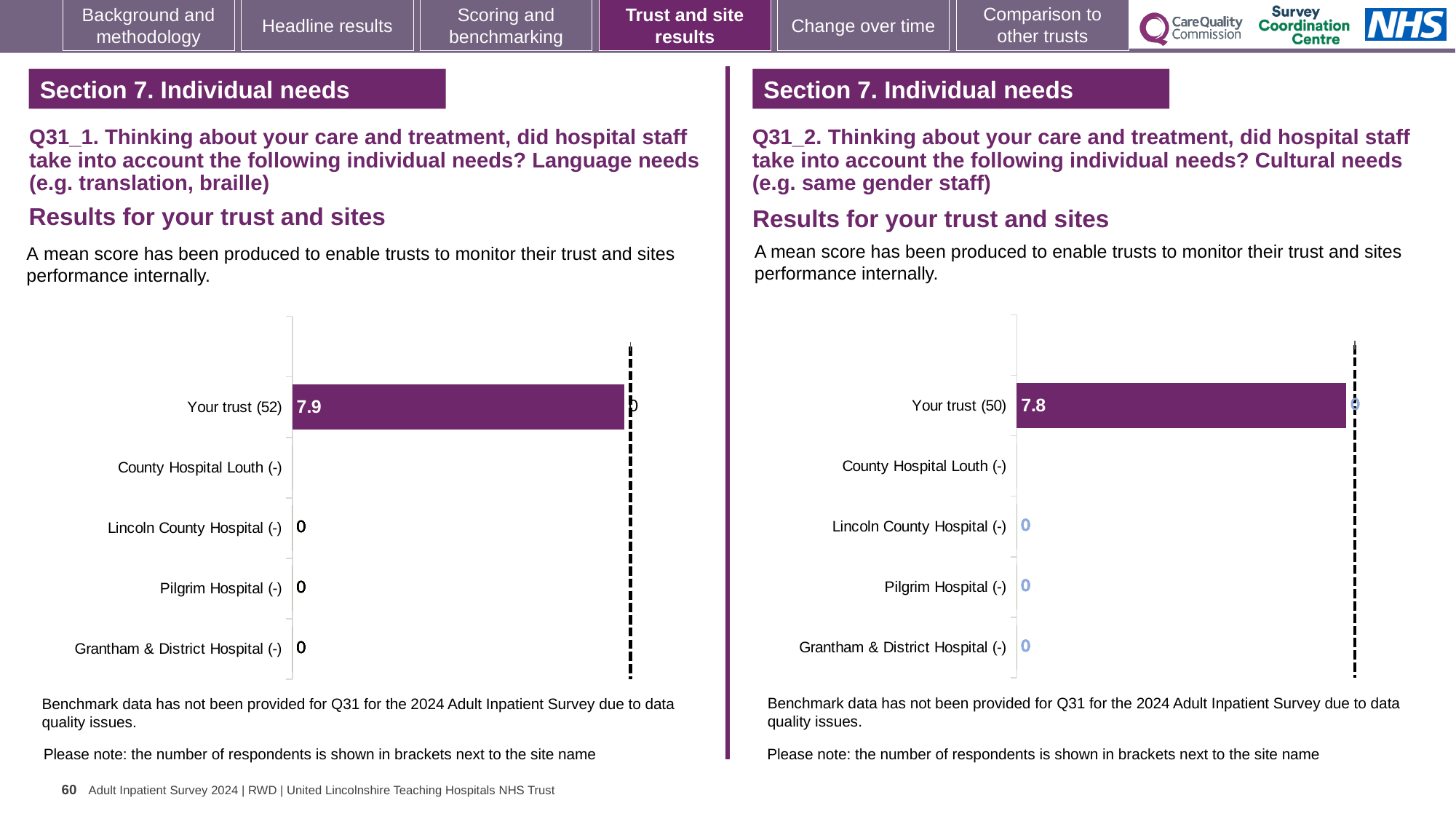
Which category has the highest value on the right chart (Q31_2, Cultural needs)? Your trust (50) On the left chart (Q31_1, Language needs), how many respondents are shown in brackets for Your trust? 52 On the right chart (Q31_2, Cultural needs), what is the mean score for Your trust? 7.8 Is the Your trust score higher on the left chart (Q31_1, Language needs) or the right chart (Q31_2, Cultural needs)? Left chart (Q31_1) What kind of chart is the left chart (Q31_1, Language needs)? Bar chart On the right chart (Q31_2, Cultural needs), how many respondents are shown in brackets for Your trust? 50 Which category has the highest value on the left chart (Q31_1, Language needs)? Your trust (52) On the left chart (Q31_1, Language needs), what is the mean score for Your trust? 7.9 How many categories are listed on the right chart (Q31_2, Cultural needs)? 5 What is the difference between the Your trust score on the left chart (Q31_1) and the Your trust score on the right chart (Q31_2)? 0.1 How many categories are listed on the left chart (Q31_1, Language needs)? 5 On the right chart (Q31_2, Cultural needs), what value is shown for Pilgrim Hospital? 0